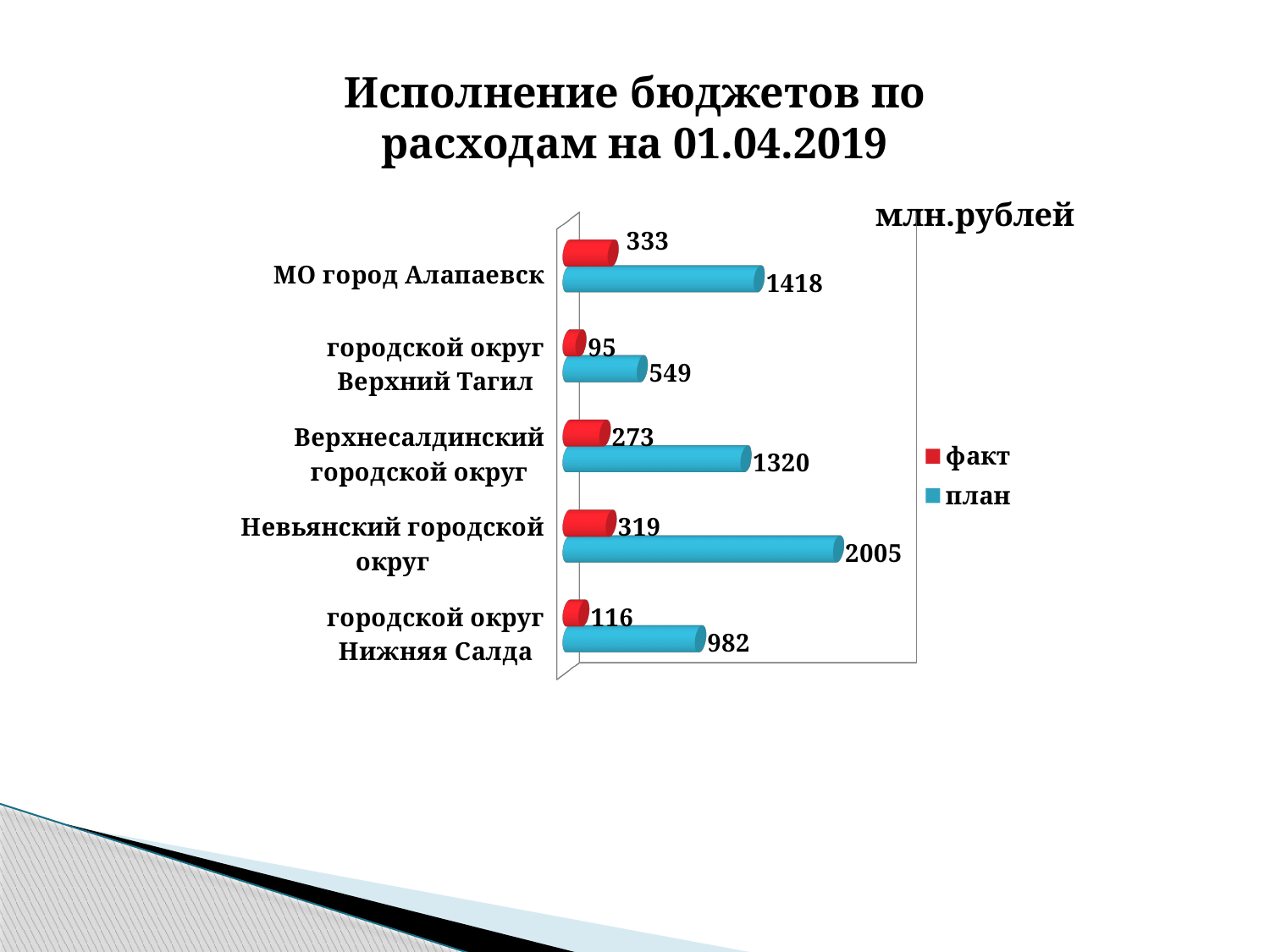
How many series does the legend list? 2 What is the факт value for Невьянский городской округ? 319 What is the факт value for городской округ Верхний Тагил? 95 What is the difference between the план and факт values for Верхнесалдинский городской округ? 1047 Which is larger: the факт value for МО город Алапаевск or the факт value for Невьянский городской округ? МО город Алапаевск What unit is indicated for the values in the chart? млн.рублей What kind of chart is shown on the slide? bar chart How many categories are shown in the chart? 5 Which category has the lowest факт value? городской округ Верхний Тагил What is the план value for городской округ Нижняя Салда? 982 What is the план value for МО город Алапаевск? 1418 Which category has the highest план value? Невьянский городской округ